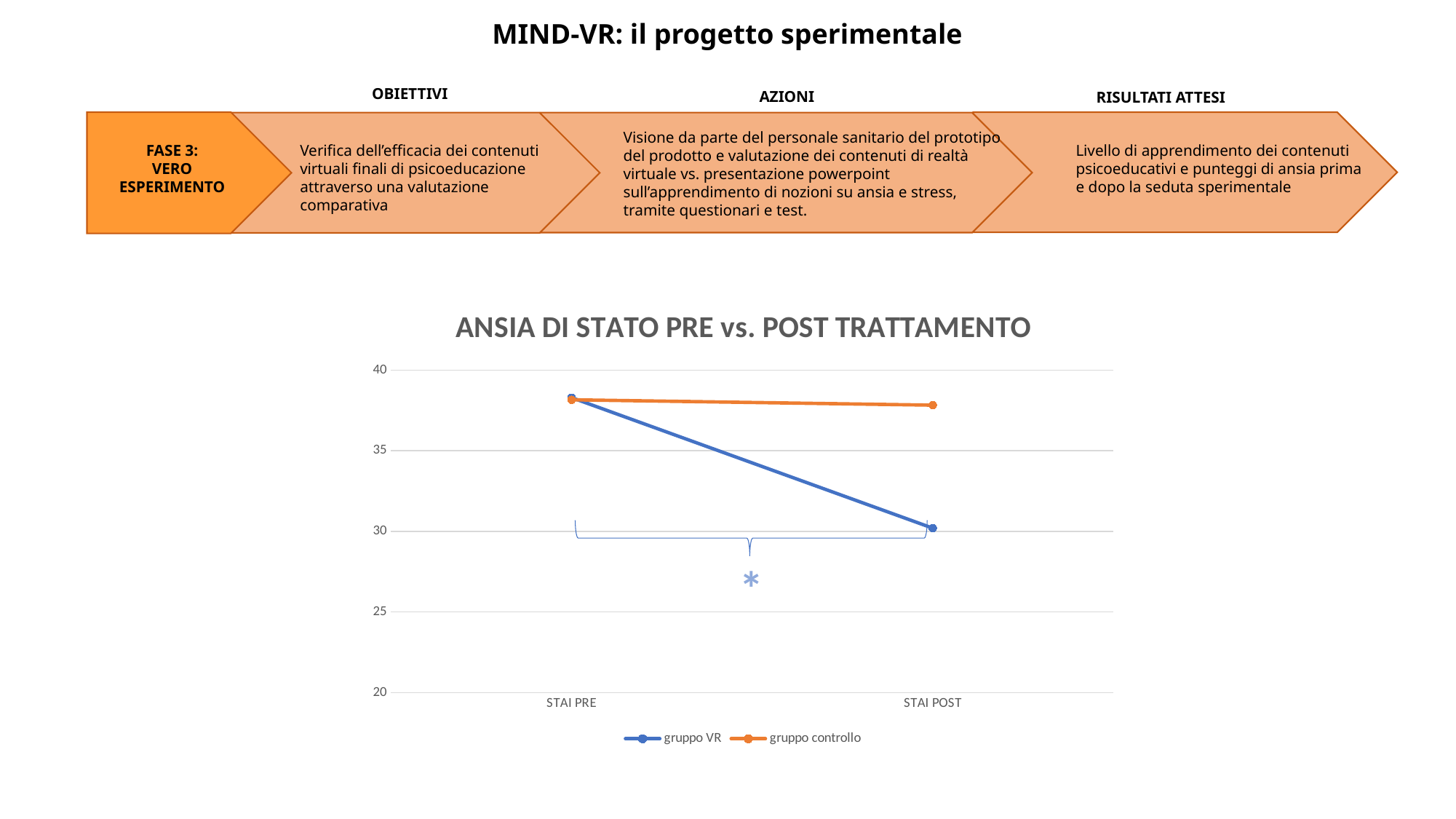
Is the value for gruppo VR at STAI POST greater or less than 35? less What kind of chart is shown on the slide? line chart Which series shows the lowest value on the chart? gruppo VR Does the gruppo VR line rise or fall from STAI PRE to STAI POST? fall How many categories are shown on the x axis of the chart? 2 What is the title of the chart? ANSIA DI STATO PRE vs. POST TRATTAMENTO Is the value for gruppo VR at STAI PRE greater or less than 35? greater Is the value for gruppo controllo at STAI POST greater or less than 35? greater Which series is drawn in orange in the chart? gruppo controllo At STAI POST, which series has the higher value, gruppo VR or gruppo controllo? gruppo controllo How many series does the chart's legend list? 2